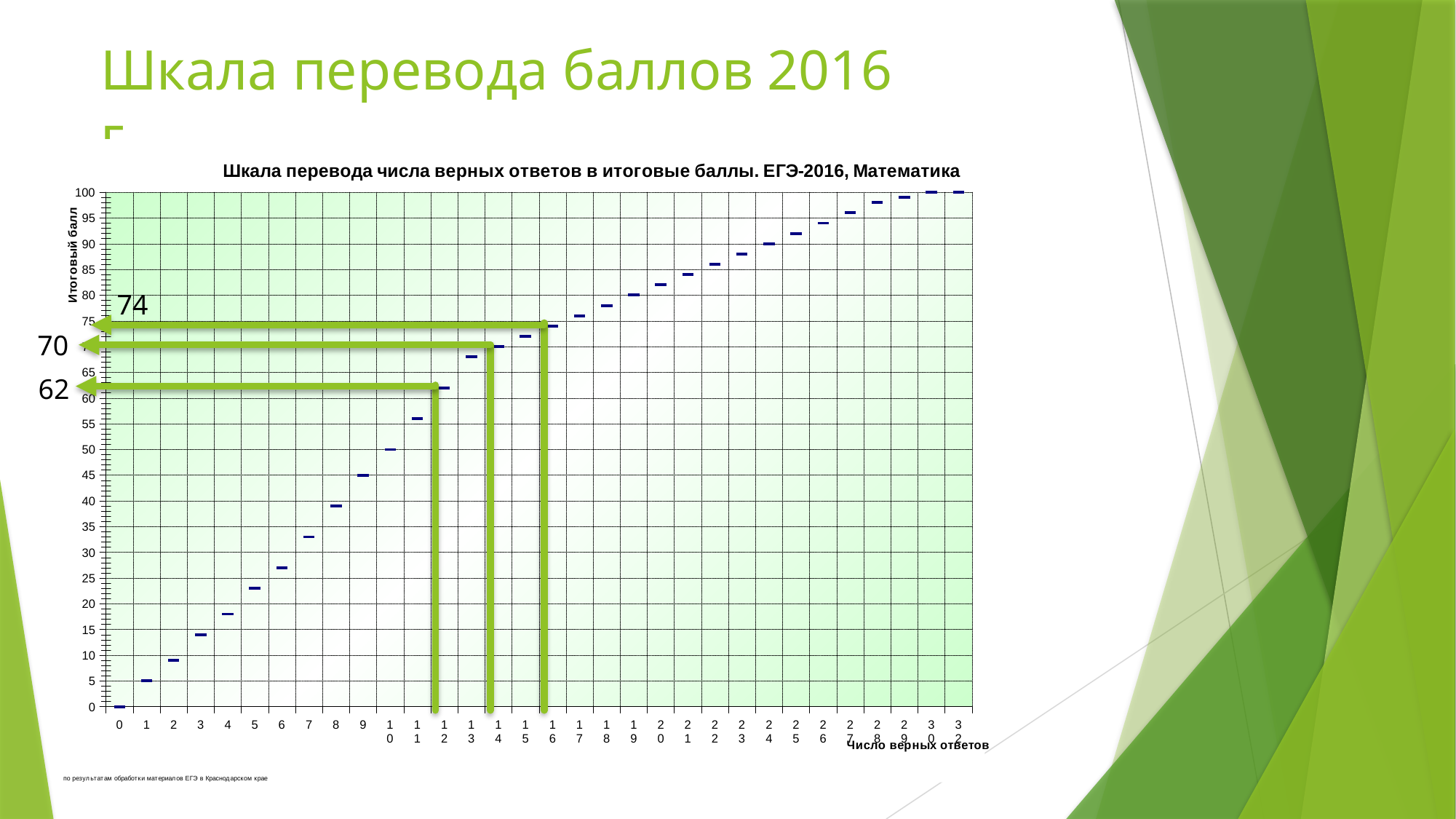
What is the difference between the final scores for 16 and 12 correct answers? 12 What final score corresponds to 32 correct answers? 100 What final score corresponds to 12 correct answers? 62 Do the final scores rise or fall as the number of correct answers increases? rise What final score corresponds to 10 correct answers? 50 Which number of correct answers gives the lowest final score? 0 What final score corresponds to 14 correct answers? 70 What final score (итоговый балл) corresponds to 16 correct answers? 74 Is the final score for 5 correct answers greater or less than 25? less What is the chart's title? Шкала перевода числа верных ответов в итоговые баллы. ЕГЭ-2016, Математика What type of chart is shown on the slide? scatter chart How many data points are plotted on the chart? 32